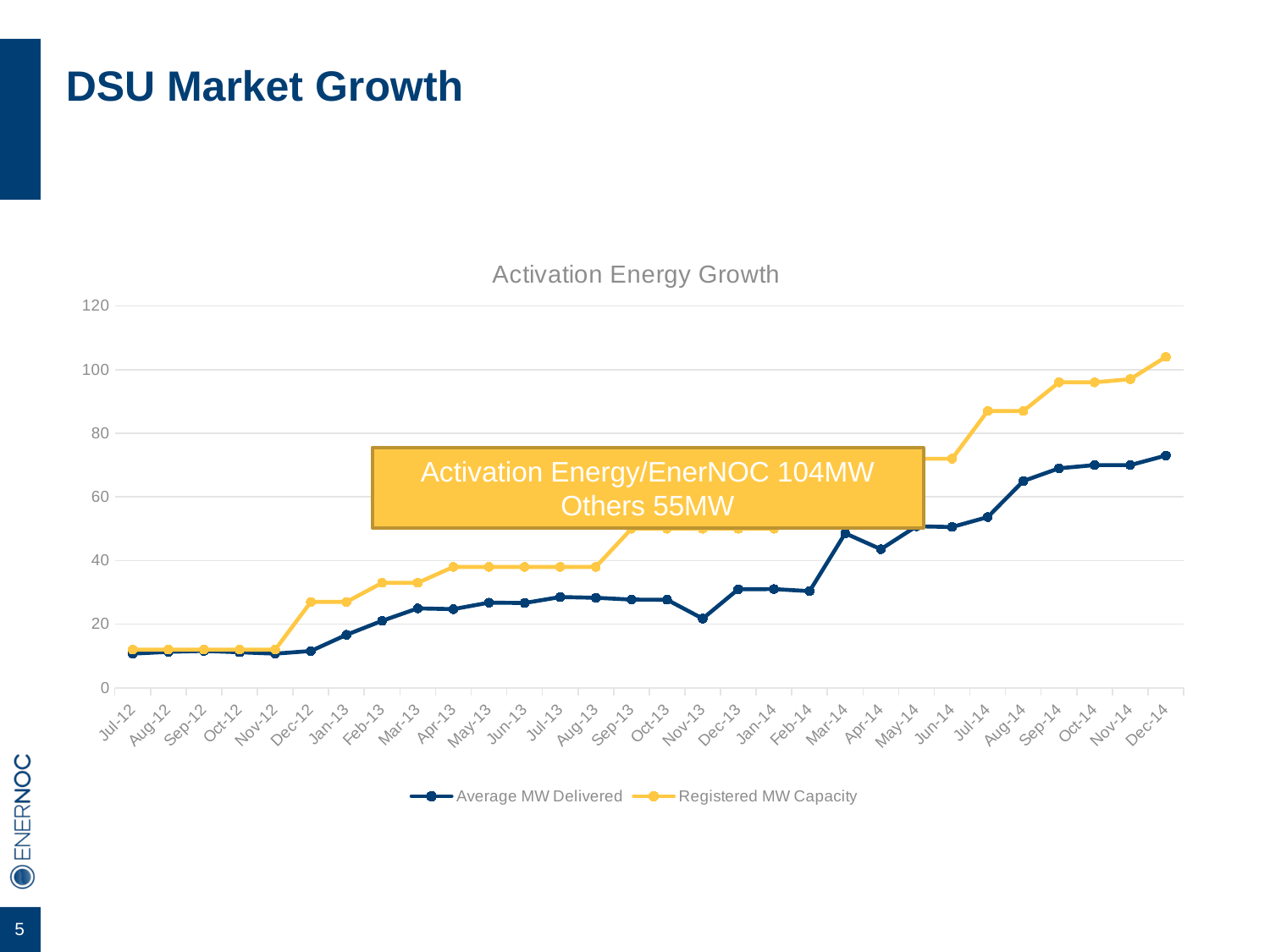
Is the value for Registered MW Capacity in Dec-14 greater or less than 100? greater In Dec-14, which series has the larger value, Average MW Delivered or Registered MW Capacity? Registered MW Capacity What type of chart is shown on the slide? Line chart Which series is drawn in yellow? Registered MW Capacity Is the value for Registered MW Capacity in Jul-14 greater or less than 80? greater Is the value for Average MW Delivered in Nov-13 greater or less than 40? less What is the title of the chart? Activation Energy Growth Do the values for Registered MW Capacity generally rise or fall from Jul-12 to Dec-14? Rise How many months are plotted along the x axis? 30 How many series does the chart's legend list? 2 In which month does Registered MW Capacity reach its highest value? Dec-14